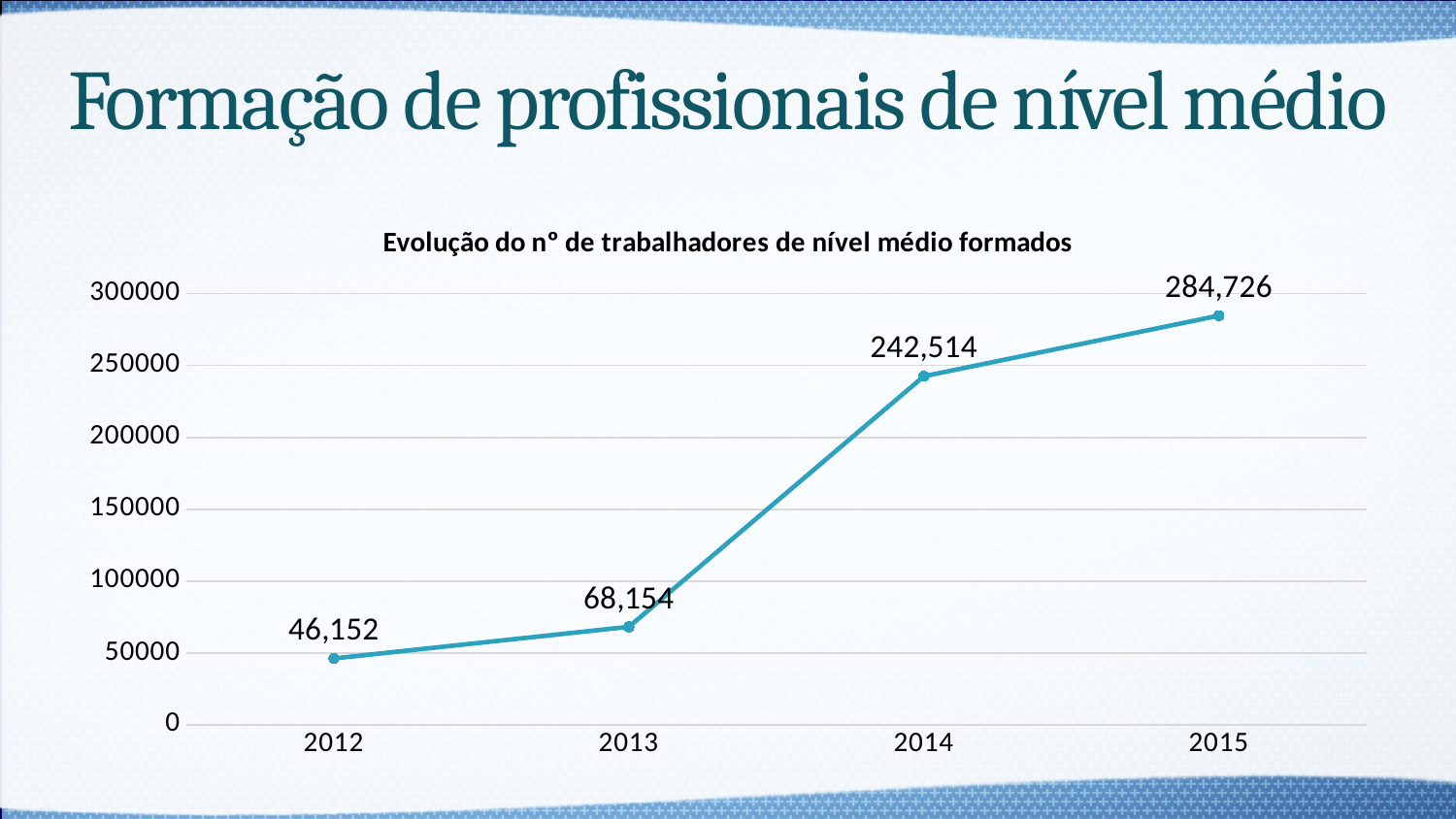
Which is larger, the value for 2013 or the value for 2014? 2014 What is the value for 2012? 46,152 What is the value for 2013? 68,154 What is the difference between the values for 2015 and 2014? 42,212 What is the value for 2014? 242,514 What kind of chart is shown on the slide? line chart Which year has the highest value? 2015 How many years are plotted on the chart? 4 Which year has the lowest value? 2012 What is the difference between the values for 2014 and 2013? 174,360 Do the values rise or fall from 2012 to 2015? rise What is the value for 2015? 284,726